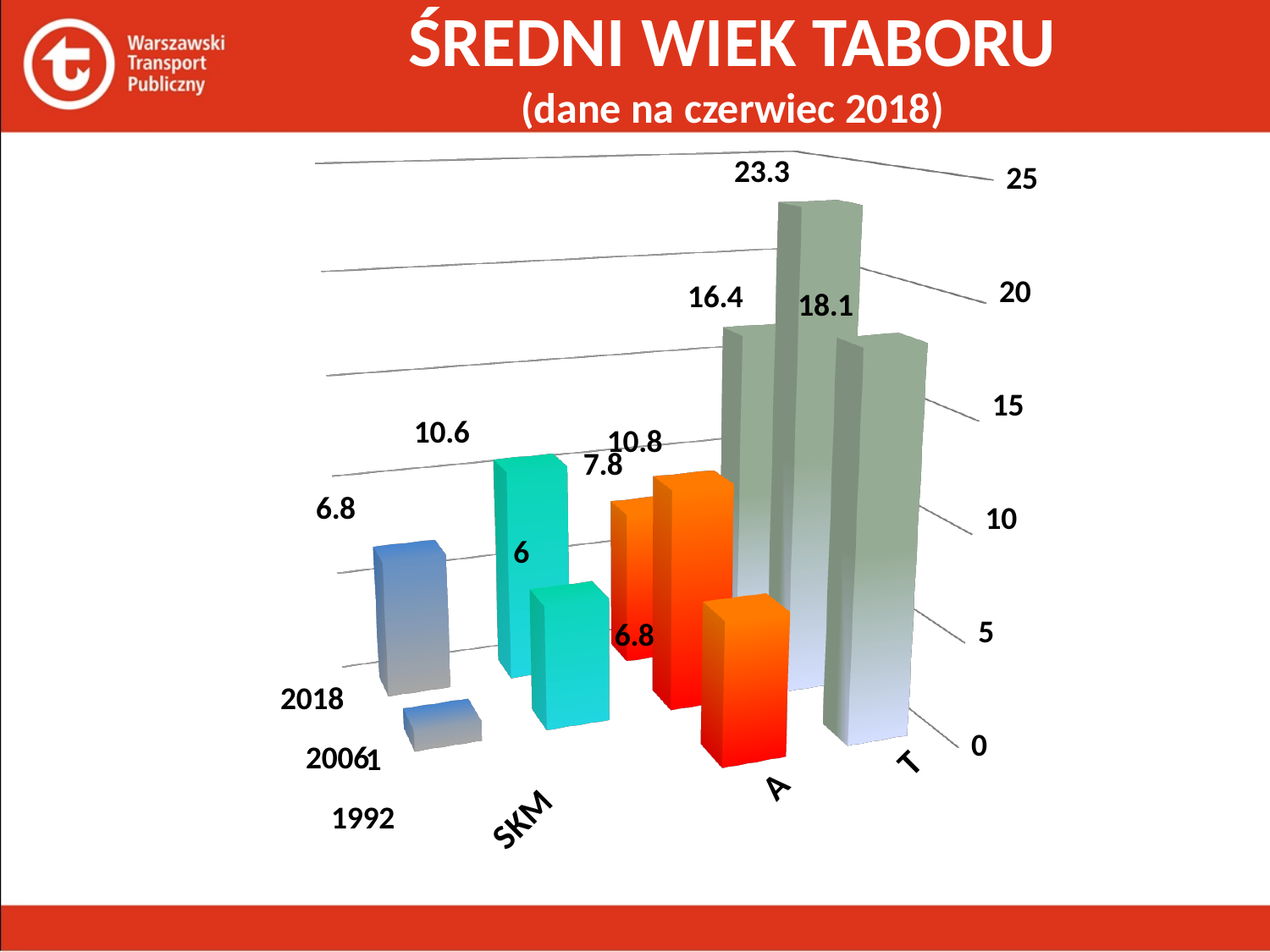
What is the title of the chart on the slide? ŚREDNI WIEK TABORU (dane na czerwiec 2018) What is the highest value labelled on the chart? 23.3 How many year series (rows) does the chart show? 3 Which is larger in 2018, the value for T or the value for A? T What is the value for A in 2018? 7.8 What is the maximum value shown on the vertical axis? 25 Is the value for T in 2018 greater or less than 15? greater What is the difference between the two labelled T values 23.3 and 18.1? 5.2 Which category has the tallest bar on the chart? T What kind of chart is shown on the slide? bar chart What is the value for SKM in 2018? 6.8 What is the value for T in 2018? 16.4